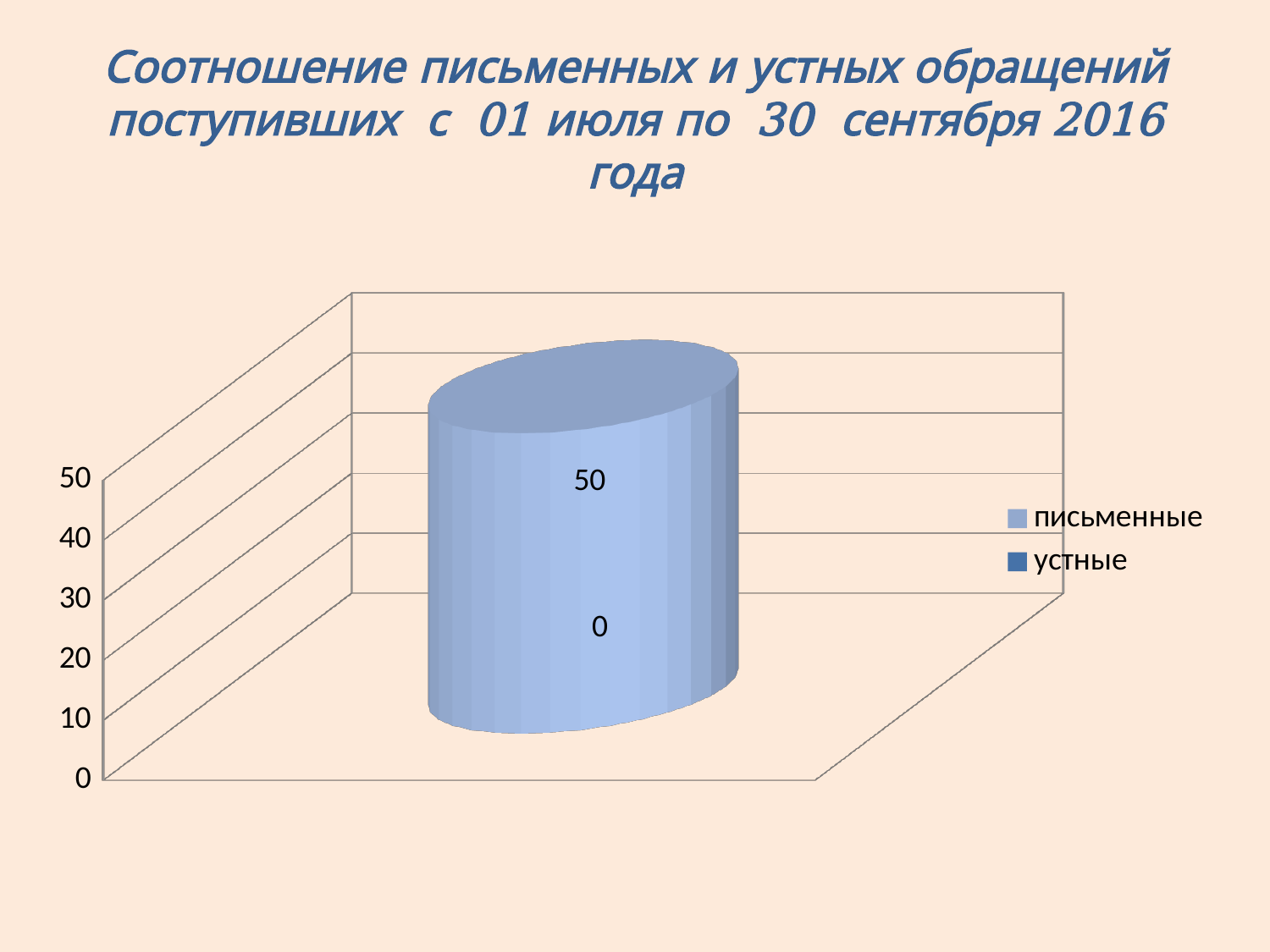
What is the difference between the values for письменные and устные? 50 Is the value for письменные greater or less than 40? greater What is the value for письменные? 50 What is the value for устные? 0 Which series has the higher value, письменные or устные? письменные Which series has the lowest value? устные What is the title of the chart? Соотношение письменных и устных обращений поступивших с 01 июля по 30 сентября 2016 года What is the maximum value shown on the vertical axis? 50 What kind of chart is shown on the slide? bar chart How many series does the legend list? 2 Which series has the highest value? письменные